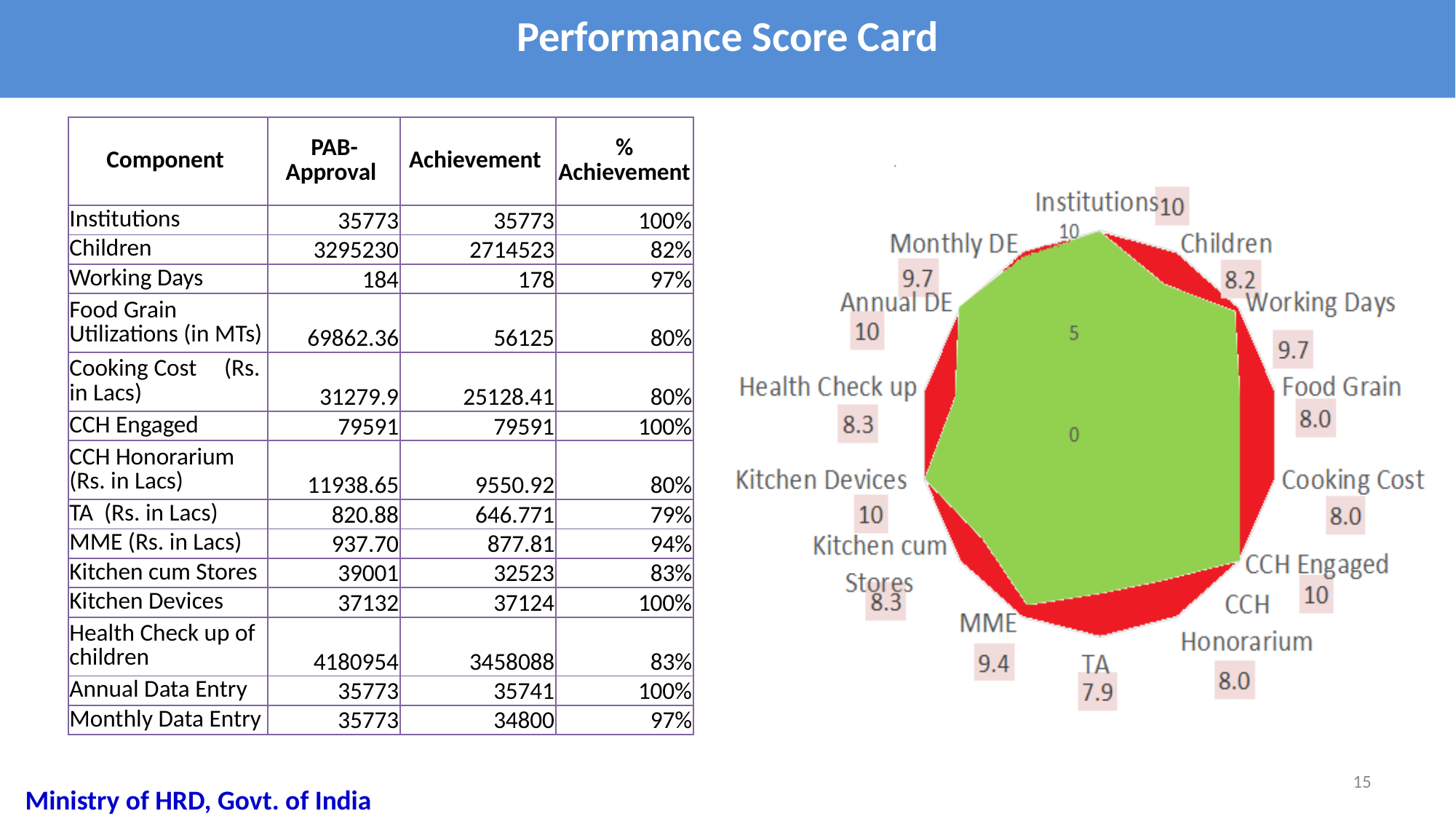
What is the value for Health Check up on the radar chart? 8.3 Which has a larger value on the radar chart, MME or TA? MME What kind of chart is shown on the right side of the slide? radar chart What is the value for Monthly DE on the radar chart? 9.7 What is the difference between the values for Working Days and Children on the radar chart? 1.5 Which category has the lowest value on the radar chart? TA What is the value for MME on the radar chart? 9.4 How many categories are plotted on the radar chart? 14 What is the highest tick value shown on the radar chart's axis? 10 What is the value for TA on the radar chart? 7.9 Is the value for Cooking Cost on the radar chart greater or less than 5? greater What is the value for Children on the radar chart? 8.2